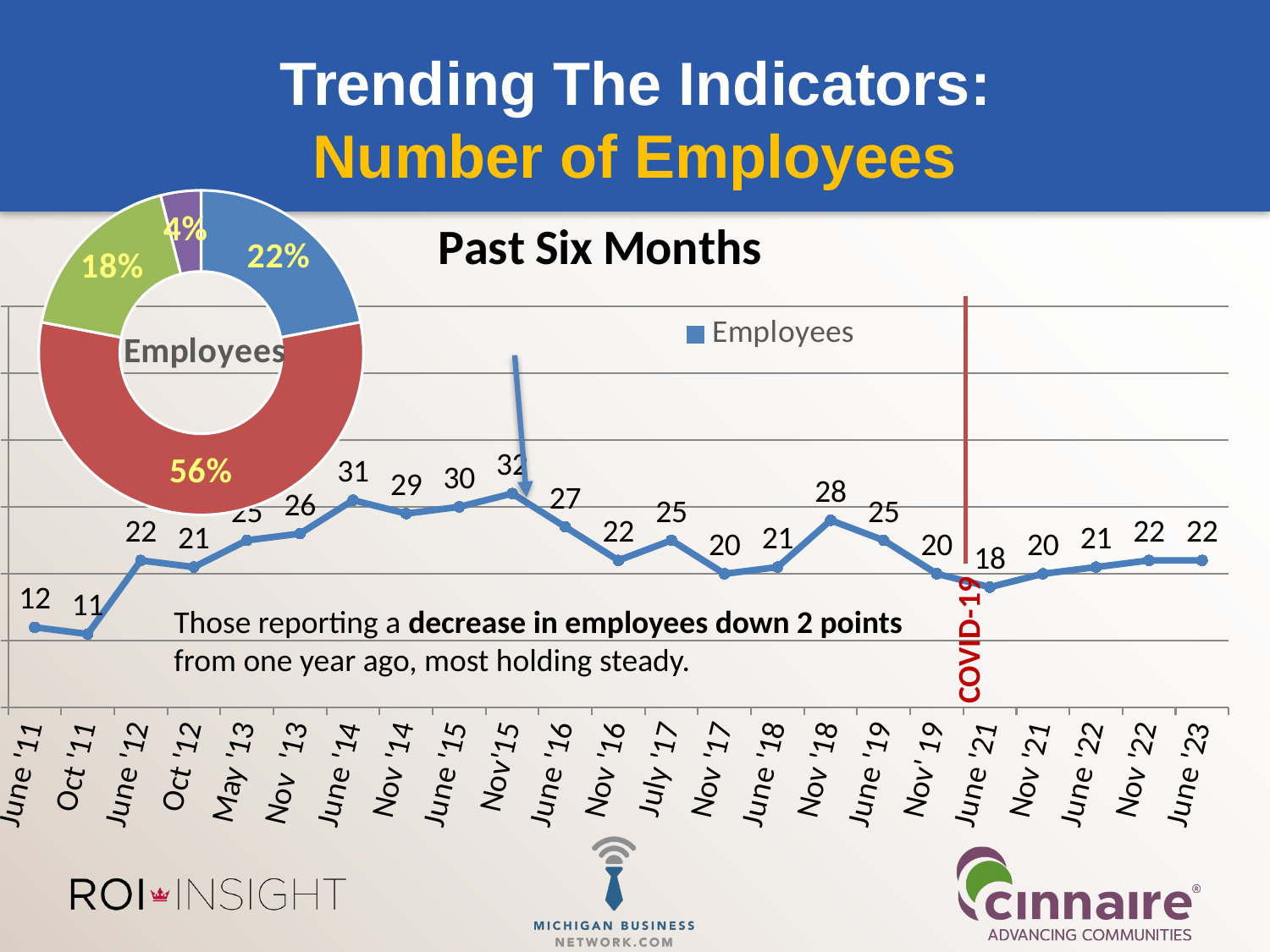
In the donut chart titled 'Employees', what share does the smallest slice (purple) have? 4% What kind of chart is the chart titled 'Past Six Months'? line chart In the donut chart titled 'Employees', what share does the largest slice (red) have? 56% In the line chart titled 'Past Six Months', how many series does the legend list? 1 In the line chart titled 'Past Six Months', how many data points are plotted? 23 In the line chart titled 'Past Six Months', what is the value for Nov'15? 32 In the line chart titled 'Past Six Months', which is larger, the value for June '14 or the value for Nov '14? June '14 In the line chart titled 'Past Six Months', what is the value for June '23? 22 In the line chart titled 'Past Six Months', what is the difference between the values for Nov '18 and June '21? 10 In the line chart titled 'Past Six Months', which period has the lowest value? Oct '11 In the line chart titled 'Past Six Months', what is the value for June '21? 18 In the line chart titled 'Past Six Months', which period has the highest value? Nov'15